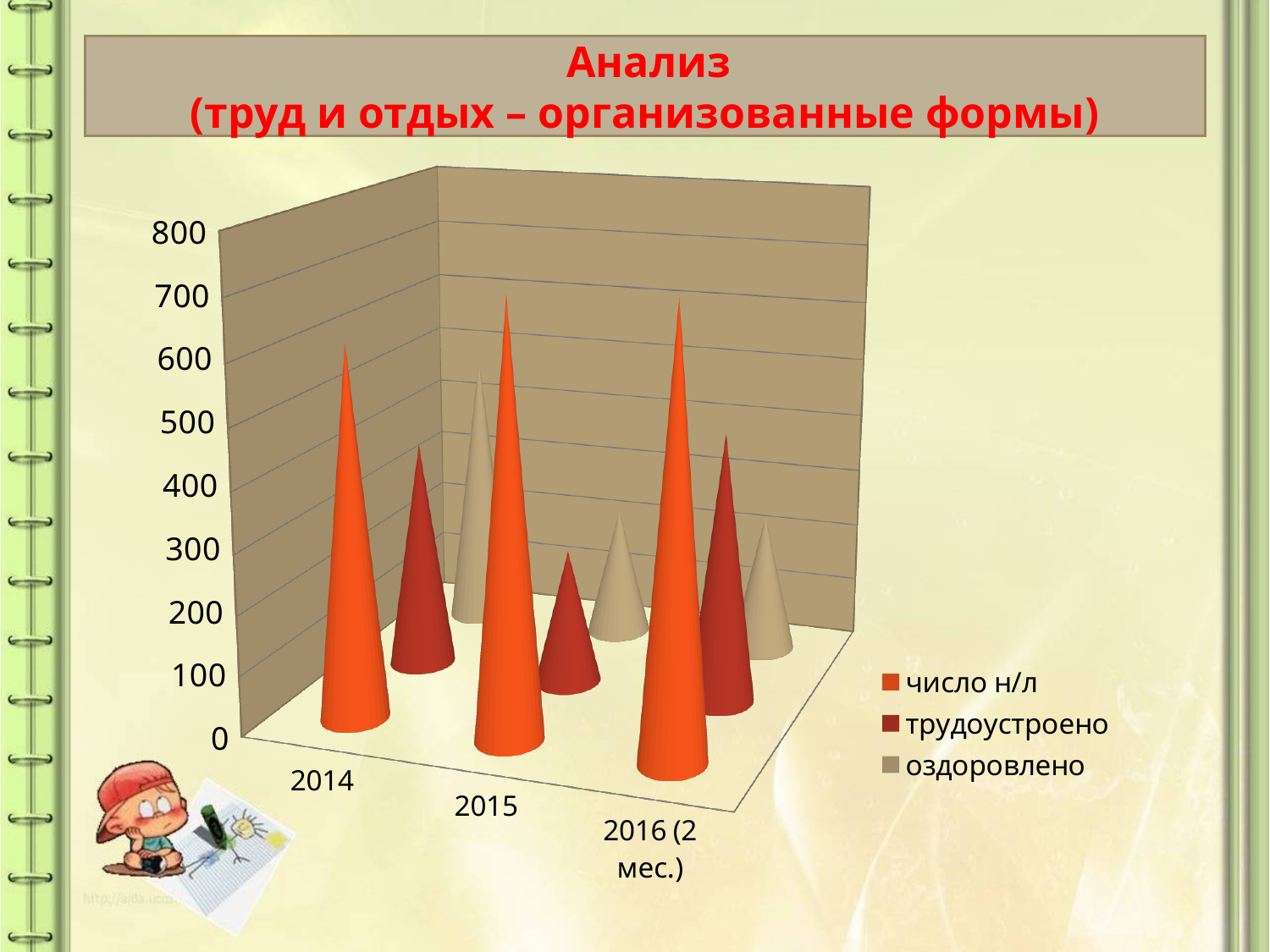
How many series does the legend list? 3 Which series is shown in orange in the legend? число н/л Which series has the highest value in 2014? число н/л What is the title of the chart on the slide? Анализ (труд и отдых – организованные формы) Is the value for число н/л in 2015 greater or less than 500? greater Is the value for трудоустроено in 2015 greater or less than 500? less What kind of chart is shown on the slide? bar chart Is the value for число н/л in 2014 greater or less than 400? greater In 2015, which is larger: число н/л or трудоустроено? число н/л How many categories are shown along the x axis? 3